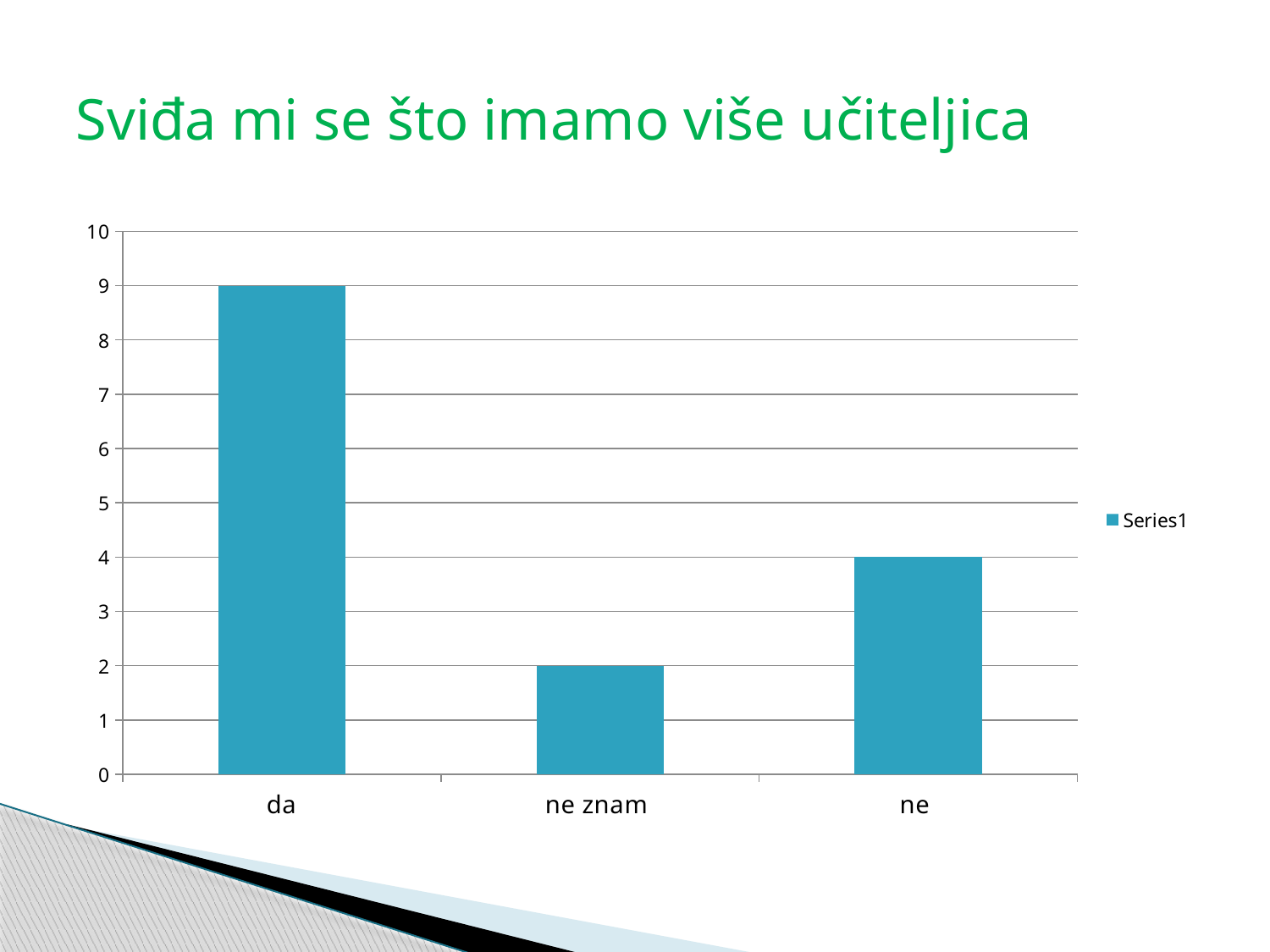
What is the name of the series listed in the legend? Series1 What is the value for "da"? 9 Is the value for "da" greater or less than 5? greater What is the value for "ne znam"? 2 Which is larger, the value for "ne" or the value for "ne znam"? ne How many categories are shown on the x axis? 3 What is the difference between the values for "da" and "ne"? 5 What is the difference between the values for "ne" and "ne znam"? 2 What kind of chart is shown on the slide? bar chart Which category has the highest value? da Which category has the lowest value? ne znam What is the value for "ne"? 4